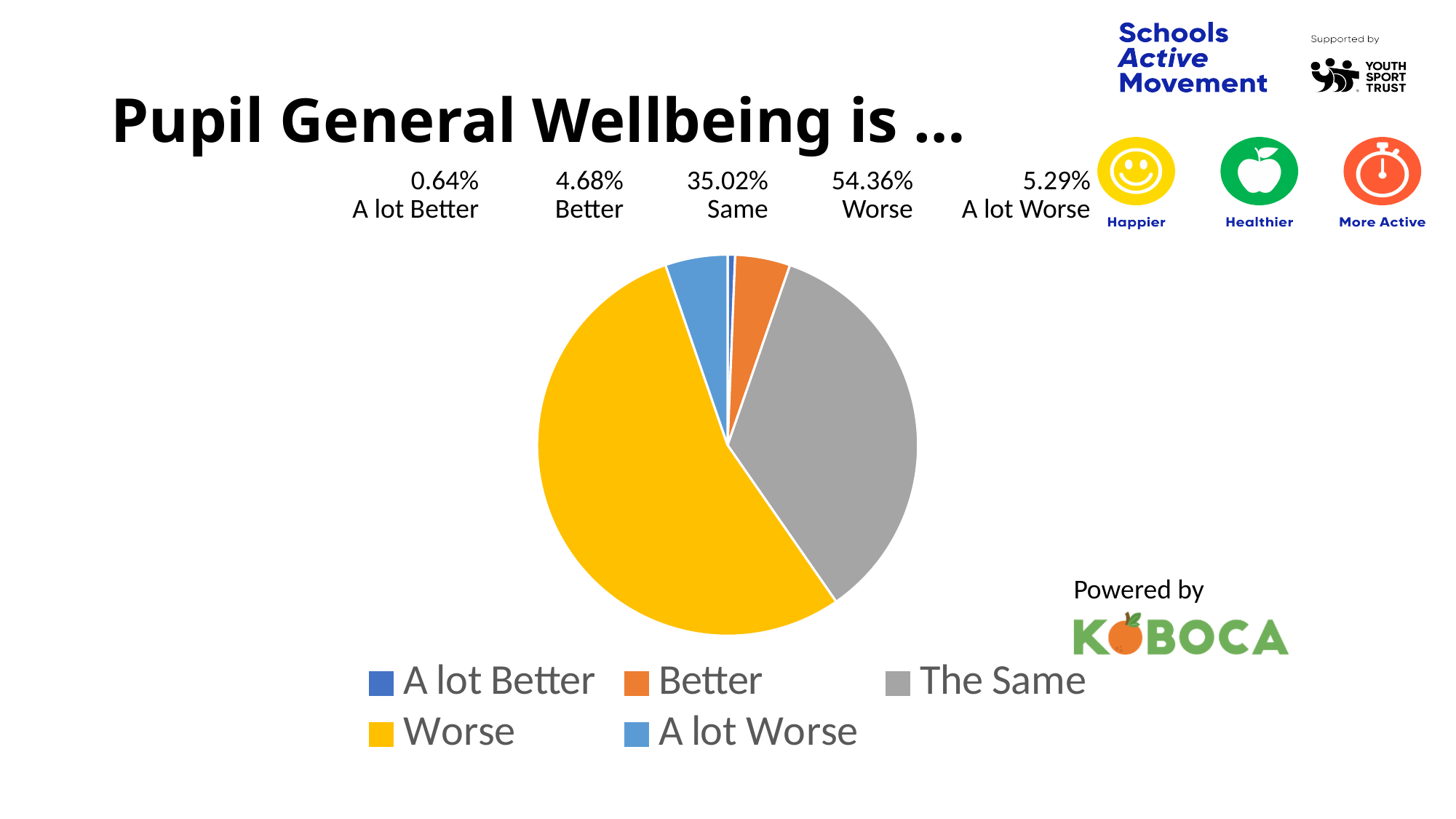
What percentage of pupils said their general wellbeing is A lot Worse? 5.29% What percentage of pupils said their general wellbeing is the Same? 35.02% What is the title of the chart? Pupil General Wellbeing is … How many categories does the pie chart show? 5 What percentage of pupils said their general wellbeing is A lot Better? 0.64% Which category has the largest share of the pie? Worse What kind of chart is shown on the slide? Pie chart Which category has the smallest share of the pie? A lot Better What percentage of pupils said their general wellbeing is Worse? 54.36% What colour is the Worse slice in the pie chart? Yellow Which is larger, the share for Better or the share for A lot Worse? A lot Worse What is the difference in percentage points between Worse and Same? 19.34